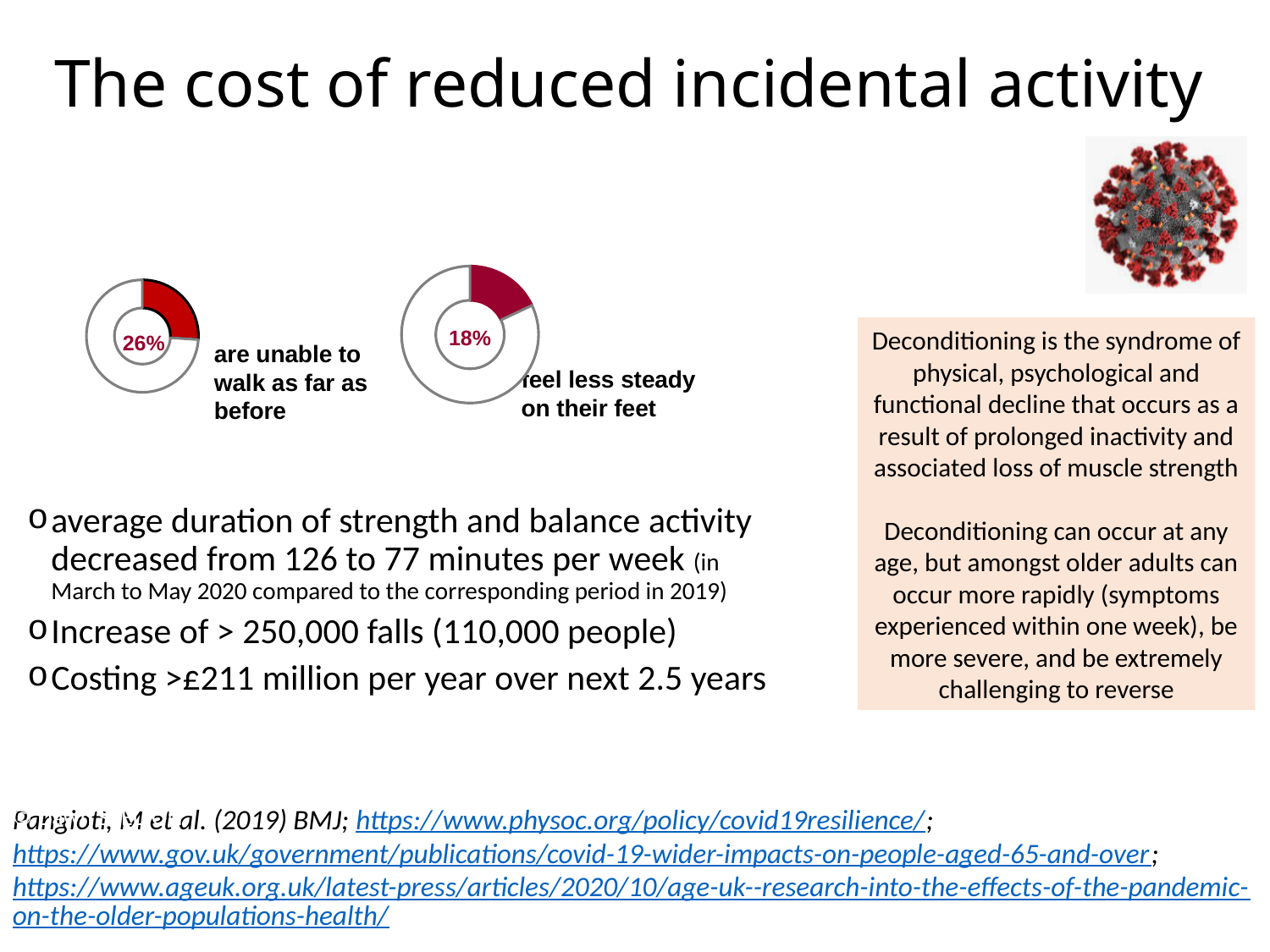
How many doughnut charts are shown on the slide? 2 What is the difference in percentage points between the left chart's value (26%) and the right chart's value (18%)? 8 percentage points On the left doughnut chart, is the highlighted share greater or less than 50%? less What label accompanies the 18% doughnut chart? feel less steady on their feet On the right doughnut chart, is the highlighted share greater or less than 25%? less Which is larger: the share unable to walk as far as before (left chart) or the share who feel less steady on their feet (right chart)? unable to walk as far as before On the right doughnut chart, what percentage feel less steady on their feet? 18% On the left doughnut chart, what percentage are unable to walk as far as before? 26% What label accompanies the 26% doughnut chart? are unable to walk as far as before What kind of chart is used to show the 26% and 18% figures? doughnut (pie) chart